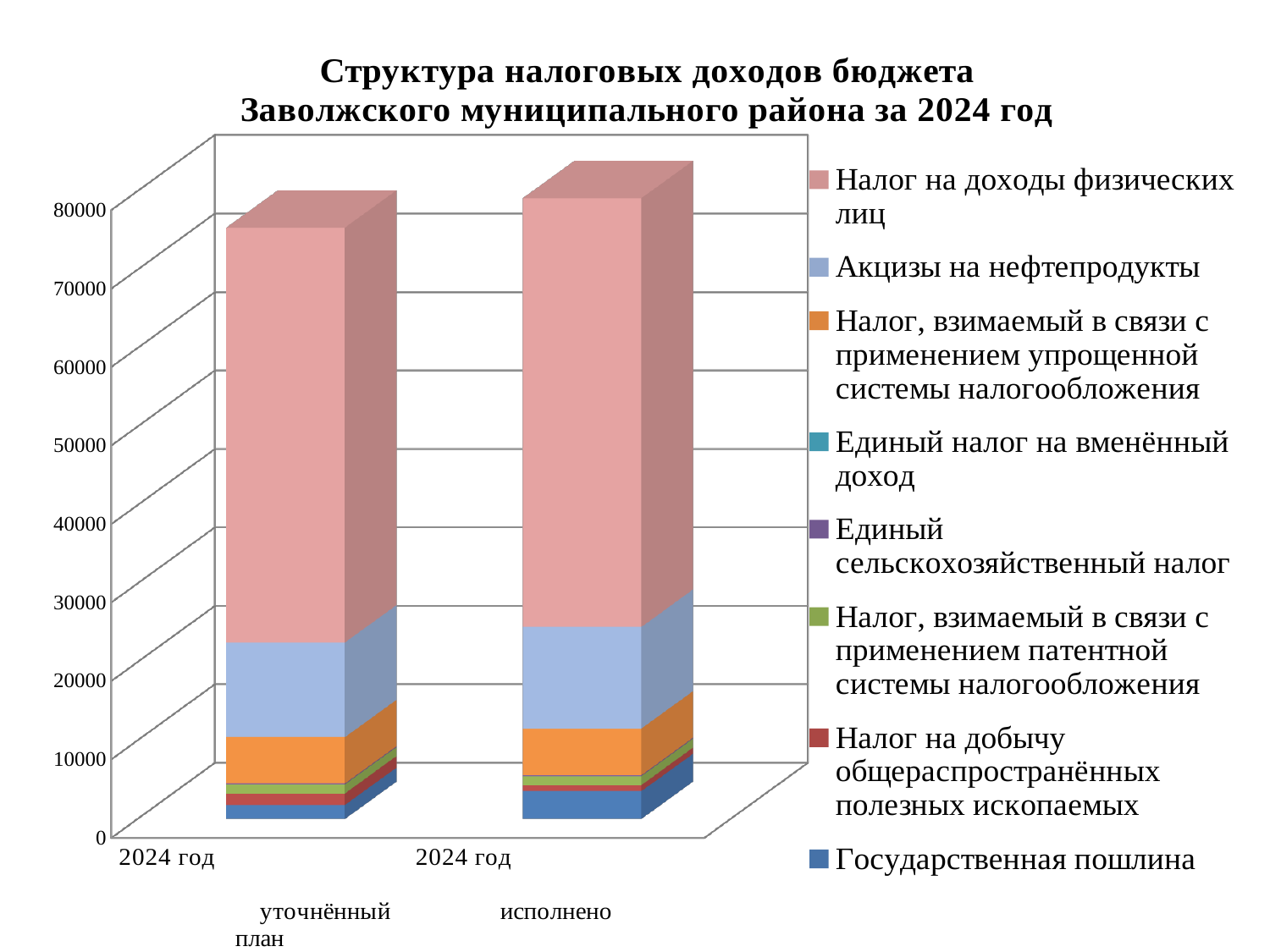
Is the "Налог на доходы физических лиц" segment of the "исполнено" bar greater or less than 50000? greater How many bars are plotted in the chart? 2 What is the title of the chart? Структура налоговых доходов бюджета Заволжского муниципального района за 2024 год Which series makes up the largest part of both bars? Налог на доходы физических лиц Is the total of the "уточнённый план" bar greater or less than 70000? greater Is the total of the "уточнённый план" bar greater or less than 80000? less Which series is shown at the bottom of each stacked bar? Государственная пошлина What kind of chart is shown on the slide? Stacked bar chart Which bar is taller, "уточнённый план" or "исполнено"? исполнено How many series does the legend list? 8